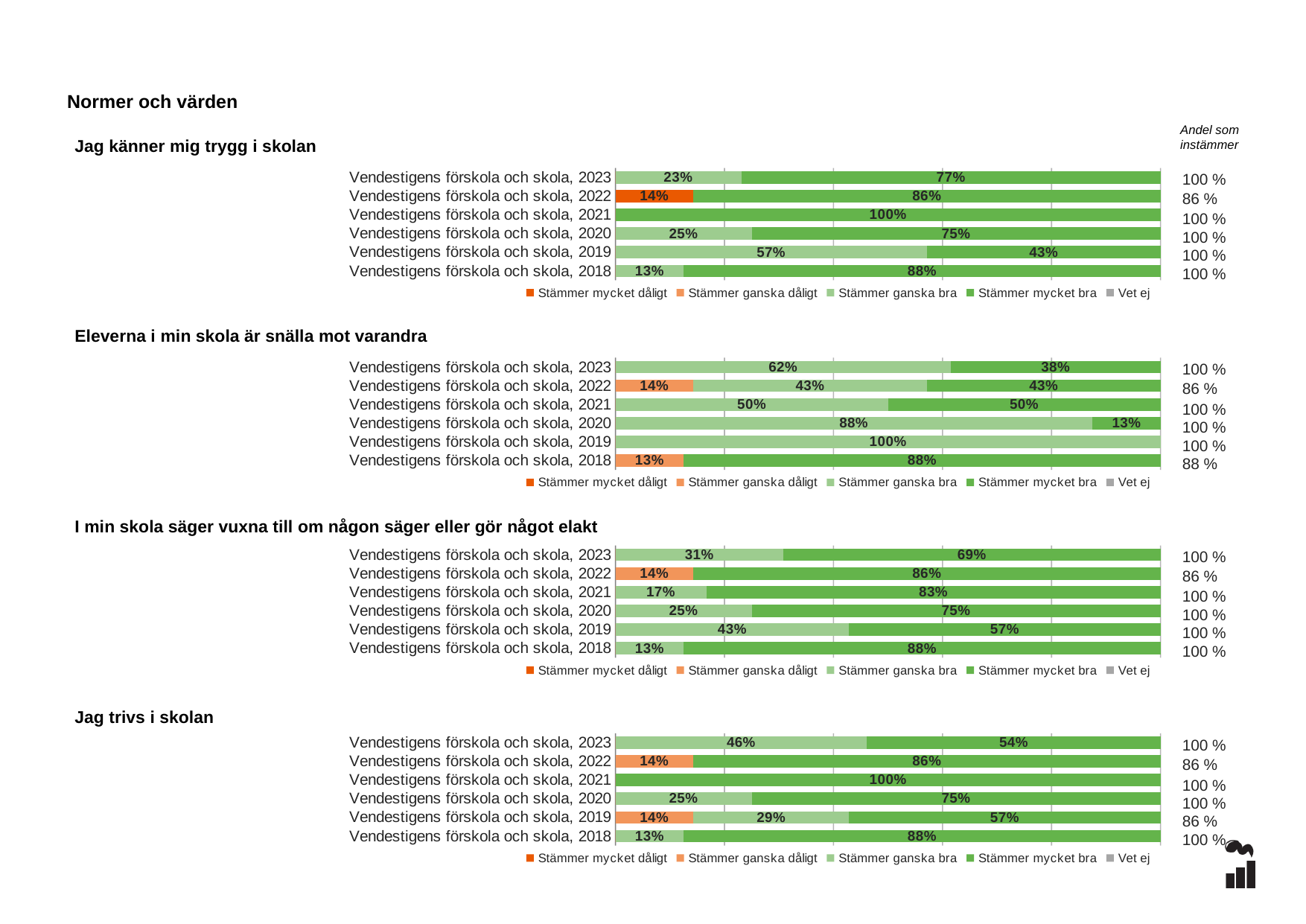
How many series does the legend list for the chart 'Jag trivs i skolan'? 5 In the chart 'I min skola säger vuxna till om någon säger eller gör något elakt', what is the 'Stämmer mycket bra' value for 2021? 83% In the chart 'Eleverna i min skola är snälla mot varandra', what is the difference between the 'Stämmer ganska bra' and 'Stämmer mycket bra' values for 2023? 24% In the chart 'Jag känner mig trygg i skolan', what is the 'Stämmer mycket dåligt' value for Vendestigens förskola och skola, 2022? 14% In the chart 'Eleverna i min skola är snälla mot varandra', what is the 'Stämmer ganska bra' value for Vendestigens förskola och skola, 2019? 100% How many years (bars) are shown in the chart 'Jag känner mig trygg i skolan'? 6 In the chart 'Eleverna i min skola är snälla mot varandra', which year has the lowest 'Stämmer mycket bra' value among years where it is shown? 2020 In the chart 'Jag trivs i skolan', what is the 'Andel som instämmer' value for 2022? 86 % In the chart 'Jag känner mig trygg i skolan', what is the 'Stämmer mycket bra' value for Vendestigens förskola och skola, 2023? 77% In the chart 'Jag trivs i skolan', what is the 'Stämmer ganska bra' value for Vendestigens förskola och skola, 2019? 29% In the chart 'Jag känner mig trygg i skolan', which year has the highest 'Stämmer mycket bra' value? 2021 In the chart 'I min skola säger vuxna till om någon säger eller gör något elakt', is the 'Stämmer mycket bra' value for 2019 larger or smaller than for 2018? smaller